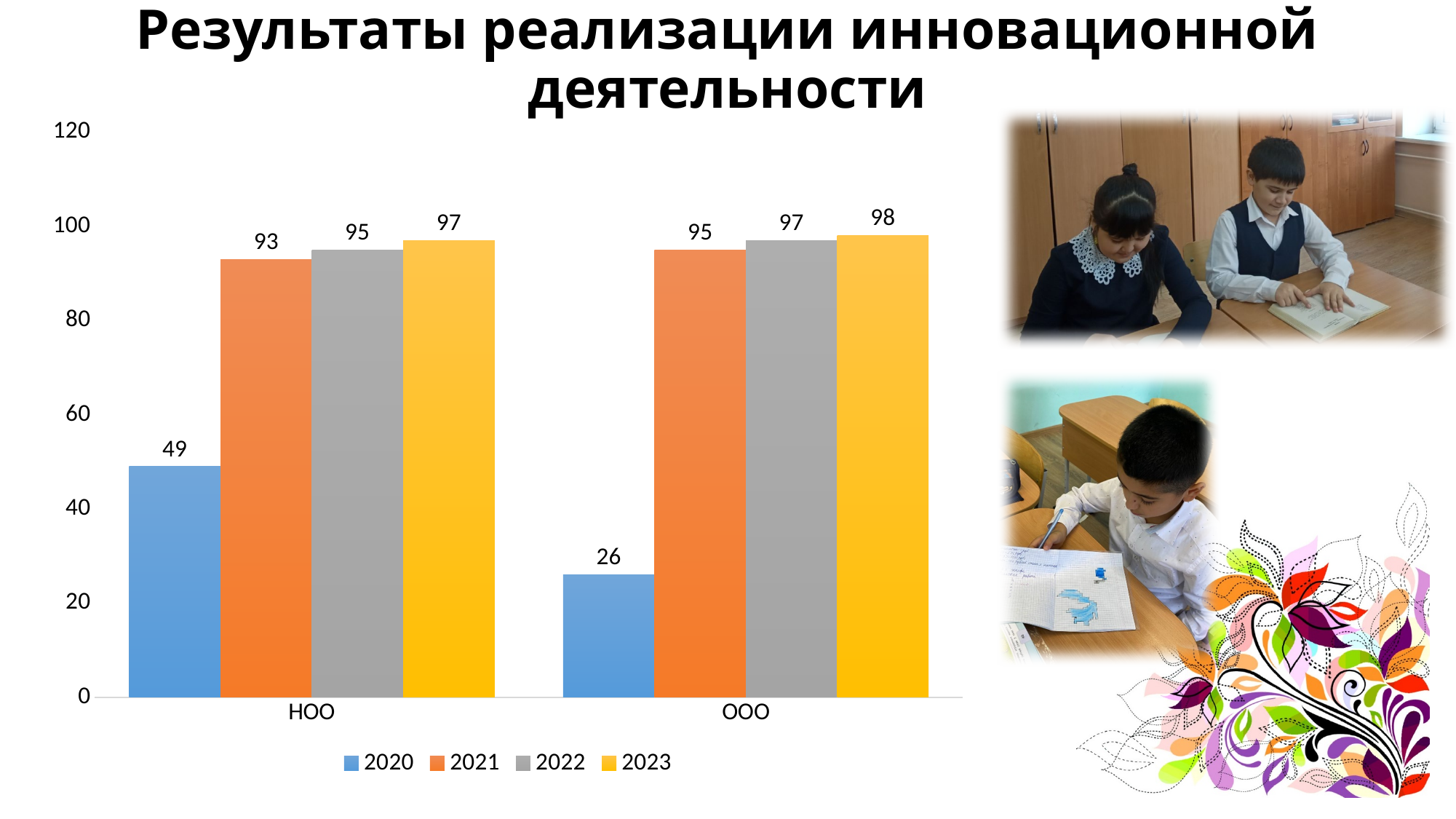
Is the value for 2020 in the ООО category greater or less than 40? less What is the value for 2023 in the ООО category? 98 What kind of chart is shown on the slide? bar chart What is the value for 2021 in the ООО category? 95 What is the difference between the 2023 and 2020 values in the НОО category? 48 Which is larger: the 2022 value for НОО or the 2022 value for ООО? ООО How many series does the legend list? 4 Which year has the highest value in the НОО category? 2023 What is the difference between the 2020 values for НОО and ООО? 23 Which year has the lowest value in the ООО category? 2020 What is the value for 2020 in the НОО category? 49 Do the values for the НОО category rise or fall from 2020 to 2023? rise